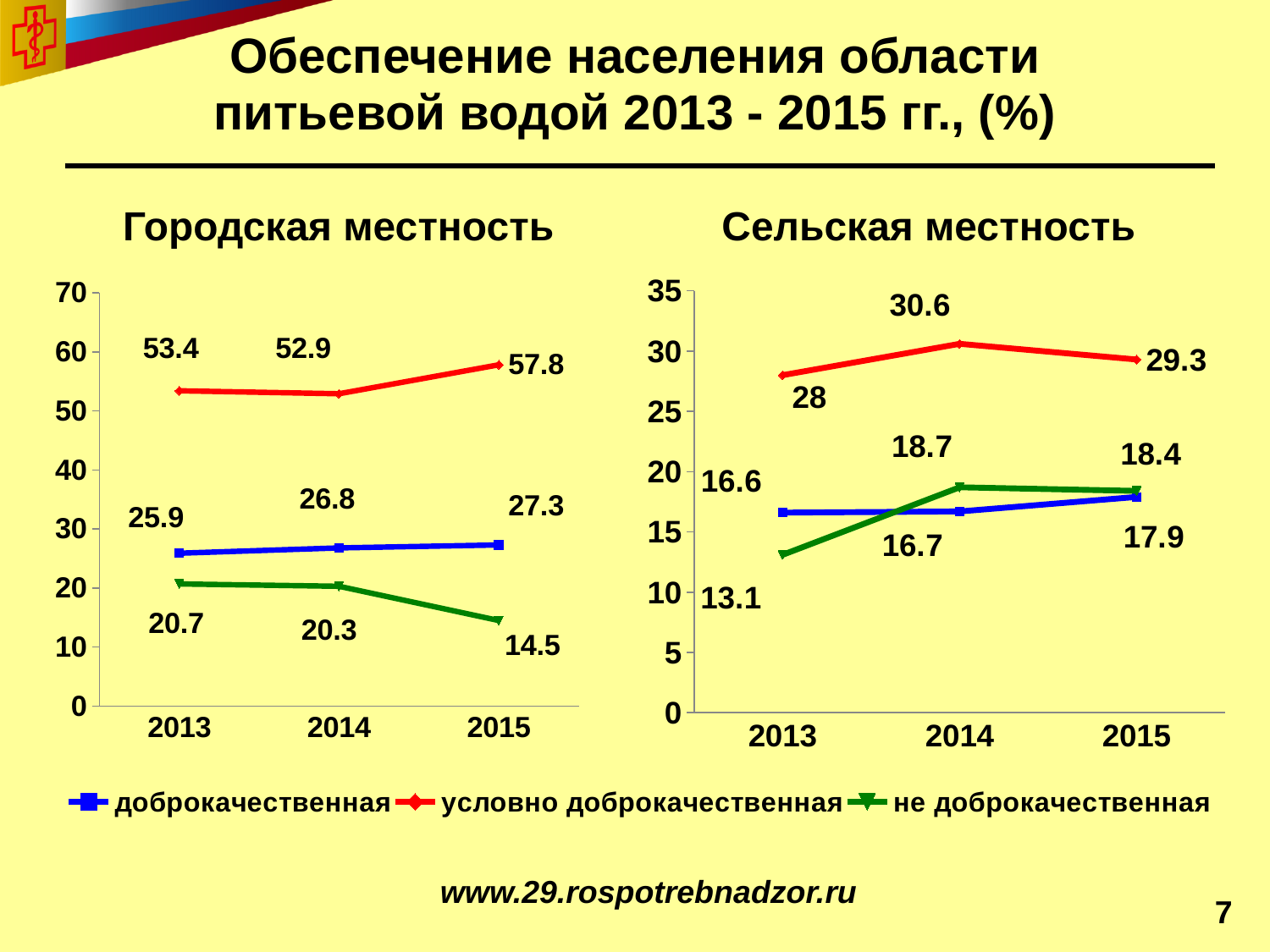
In the 'Городская местность' chart, in which year is the 'условно доброкачественная' value highest? 2015 In the 'Сельская местность' chart, what is the value for 'доброкачественная' in 2014? 16.7 How many series does the legend list? 3 In the 'Городская местность' chart, what is the difference between the 'условно доброкачественная' values in 2015 and 2014? 4.9 In the 'Городская местность' chart, which is larger in 2015: 'доброкачественная' or 'не доброкачественная'? доброкачественная What type of chart is the 'Сельская местность' chart? line chart In the 'Городская местность' chart, does the 'не доброкачественная' series rise or fall from 2013 to 2015? fall In the 'Городская местность' chart, what is the value for 'не доброкачественная' in 2013? 20.7 In the 'Сельская местность' chart, what is the value for 'условно доброкачественная' in 2014? 30.6 In the 'Сельская местность' chart, what is the difference between the 'не доброкачественная' values in 2014 and 2013? 5.6 In the 'Сельская местность' chart, in which year is the 'не доброкачественная' value lowest? 2013 In the 'Городская местность' chart, what is the value for 'условно доброкачественная' in 2015? 57.8